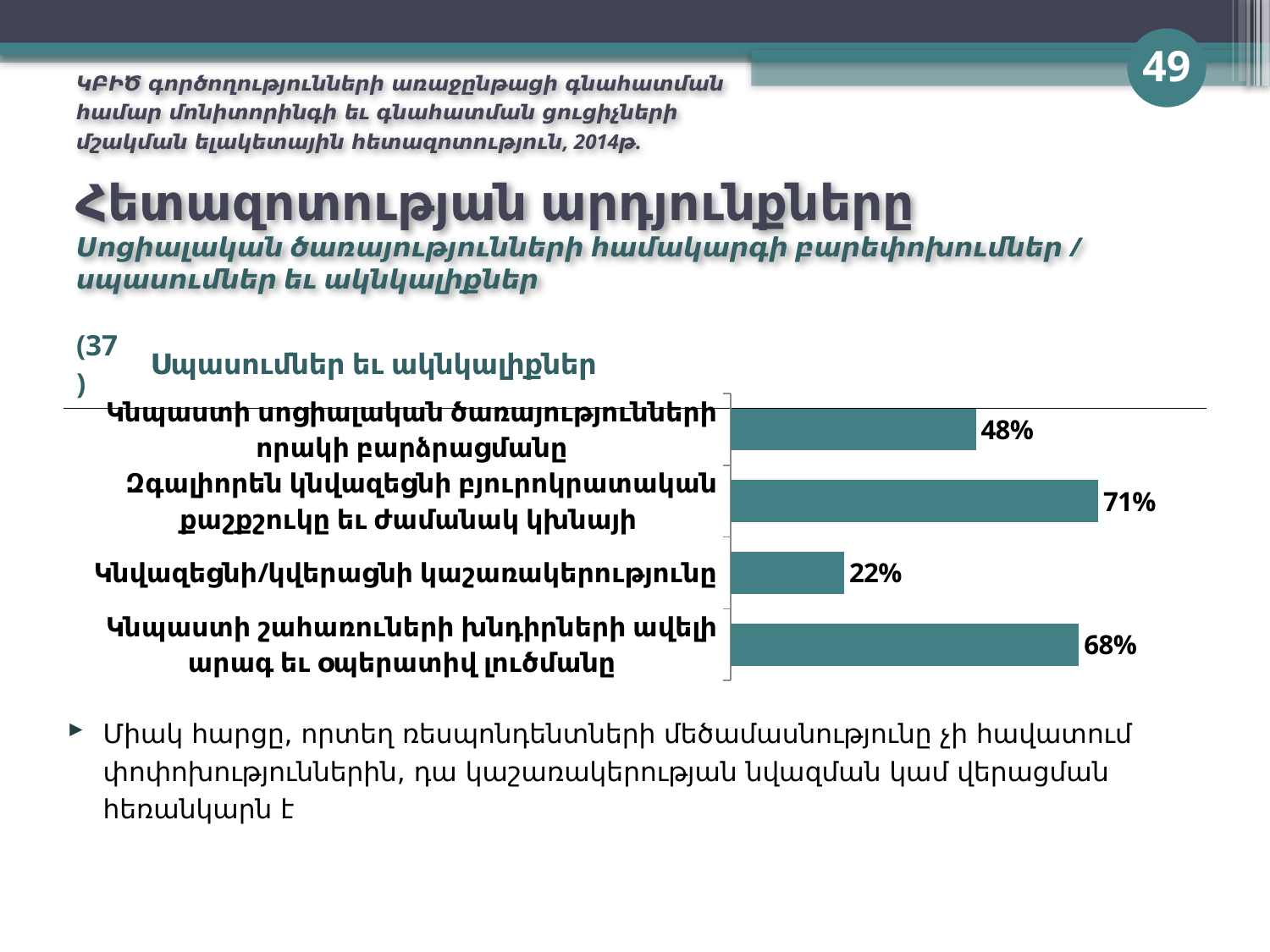
What is the value for "Կնպաստի սոցիալական ծառայությունների որակի բարձրացմանը"? 48% What is the difference between the values for "Կնպաստի շահառուների խնդիրների ավելի արագ և օպերատիվ լուծմանը" and "Կնպաստի սոցիալական ծառայությունների որակի բարձրացմանը"? 20% What type of chart is shown on the slide? Bar chart Which category has the highest value in the chart? Զգալիորեն կնվազեցնի բյուրոկրատական քաշքշուկը և ժամանակ կխնայի What is the value for "Կնվազեցնի/կվերացնի կաշառակերությունը" in the "Սպասումներ և ակնկալիքներ" chart? 22% What is the title of the chart on the slide? Սպասումներ և ակնկալիքներ What value is shown for "Կնպաստի շահառուների խնդիրների ավելի արագ և օպերատիվ լուծմանը"? 68% What percentage is shown for "Զգալիորեն կնվազեցնի բյուրոկրատական քաշքշուկը և ժամանակ կխնայի"? 71% What is the difference between the values for "Զգալիորեն կնվազեցնի բյուրոկրատական քաշքշուկը և ժամանակ կխնայի" and "Կնվազեցնի/կվերացնի կաշառակերությունը"? 49% How many categories are shown in the chart? 4 Which category has the lowest value in the chart? Կնվազեցնի/կվերացնի կաշառակերությունը Which is larger: the value for "Կնպաստի սոցիալական ծառայությունների որակի բարձրացմանը" or for "Կնպաստի շահառուների խնդիրների ավելի արագ և օպերատիվ լուծմանը"? Կնպաստի շահառուների խնդիրների ավելի արագ և օպերատիվ լուծմանը